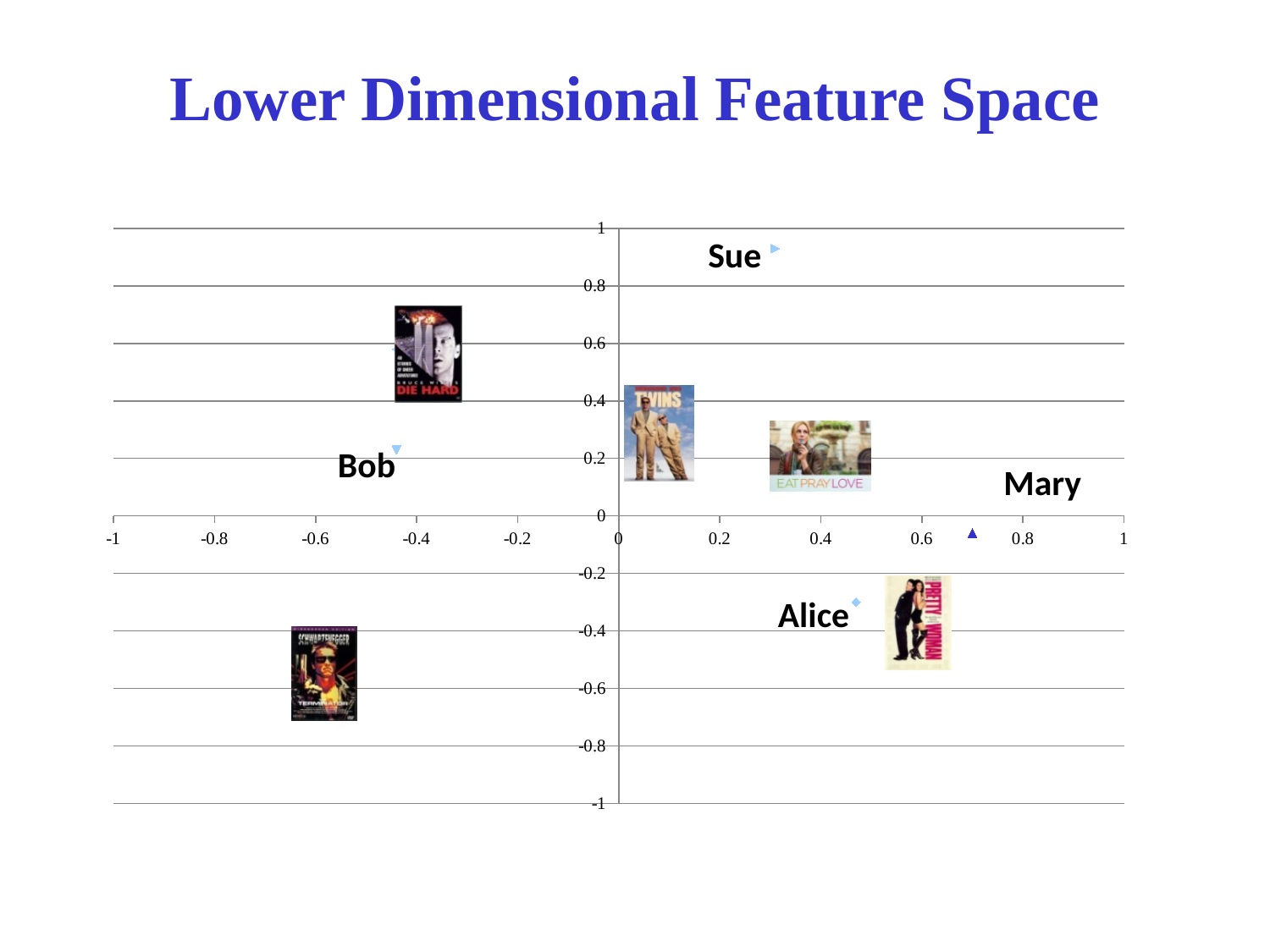
What is the title of the chart on the slide? Lower Dimensional Feature Space What kind of chart is shown on the slide? scatter chart Which point is higher on the vertical axis, Sue or Bob? Sue Which labeled point has the largest horizontal-axis value? Mary Which labeled point has the smallest horizontal-axis value? Bob Is the vertical-axis value for Sue greater or less than 0.8? greater Which labeled point has the highest vertical-axis value? Sue Is the vertical-axis value for Alice greater or less than 0? less Which labeled point has the lowest vertical-axis value? Alice Is the horizontal-axis value for Bob greater or less than -0.2? less How many labeled people are plotted as points on the chart? 4